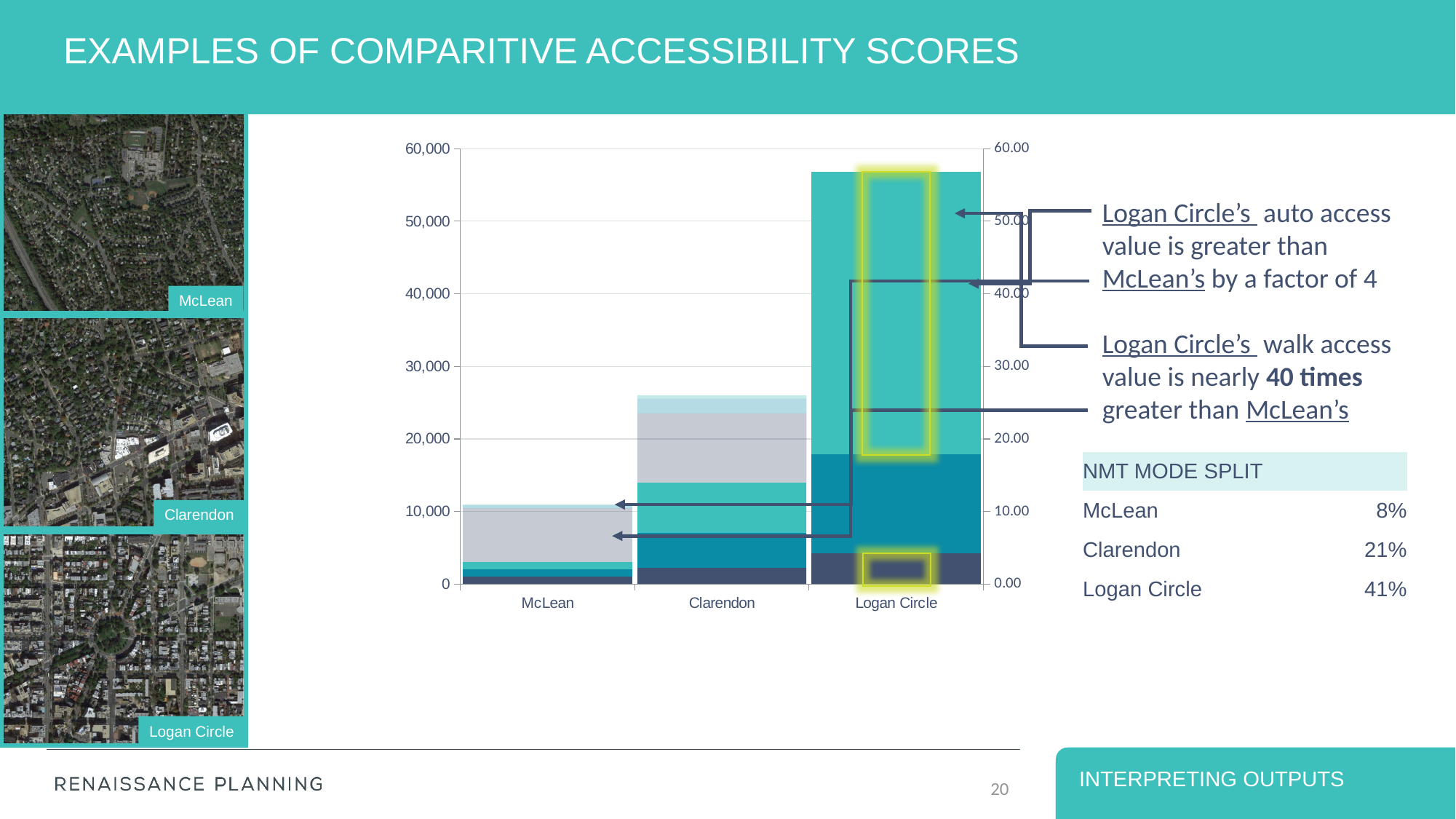
Which stacked bar is taller, Clarendon or McLean? Clarendon What is the highest value shown on the left vertical axis of the chart? 60,000 What is the highest value shown on the right vertical axis of the chart? 60.00 Is the total height of the Clarendon bar greater or less than 30,000 on the left axis? less Is the total height of the Logan Circle bar greater or less than 50,000 on the left axis? greater Which stacked bar is taller, Logan Circle or Clarendon? Logan Circle Is the total height of the McLean bar greater or less than 20,000 on the left axis? less What kind of chart is shown on the slide? Stacked bar chart Which category has the shortest stacked bar in the chart? McLean Which category has the tallest stacked bar in the chart? Logan Circle How many categories are shown on the x axis of the chart? 3